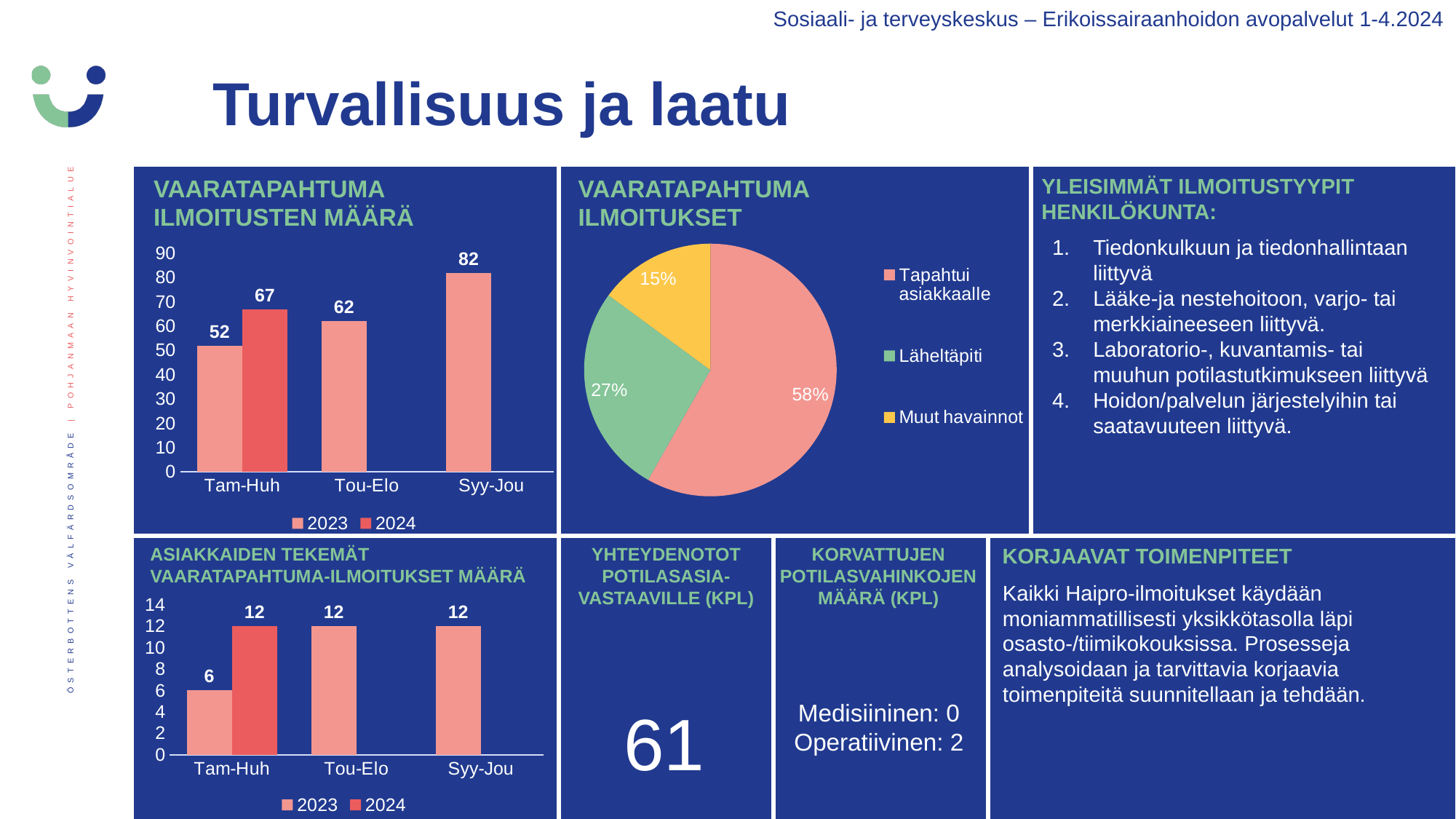
In the chart titled ASIAKKAIDEN TEKEMÄT VAARATAPAHTUMA-ILMOITUKSET MÄÄRÄ, which is larger for Tam-Huh, the 2023 or the 2024 value? 2024 In the pie chart titled VAARATAPAHTUMA ILMOITUKSET, which category has the smallest slice? Muut havainnot In the chart titled VAARATAPAHTUMA ILMOITUSTEN MÄÄRÄ, what is the 2024 value for Tam-Huh? 67 In the chart titled VAARATAPAHTUMA ILMOITUSTEN MÄÄRÄ, do the 2023 values rise or fall from Tam-Huh to Syy-Jou? rise In the pie chart titled VAARATAPAHTUMA ILMOITUKSET, how many slices are there? 3 In the pie chart titled VAARATAPAHTUMA ILMOITUKSET, what share is Läheltäpiti? 27% In the chart titled VAARATAPAHTUMA ILMOITUSTEN MÄÄRÄ, how many series does the legend list? 2 In the chart titled VAARATAPAHTUMA ILMOITUSTEN MÄÄRÄ, what is the 2023 value for Syy-Jou? 82 In the chart titled VAARATAPAHTUMA ILMOITUSTEN MÄÄRÄ, what is the difference between the 2024 and 2023 values for Tam-Huh? 15 In the chart titled ASIAKKAIDEN TEKEMÄT VAARATAPAHTUMA-ILMOITUKSET MÄÄRÄ, what is the 2023 value for Tam-Huh? 6 What kind of chart is the one titled VAARATAPAHTUMA ILMOITUKSET? pie chart In the chart titled VAARATAPAHTUMA ILMOITUSTEN MÄÄRÄ, which period has the highest 2023 value? Syy-Jou